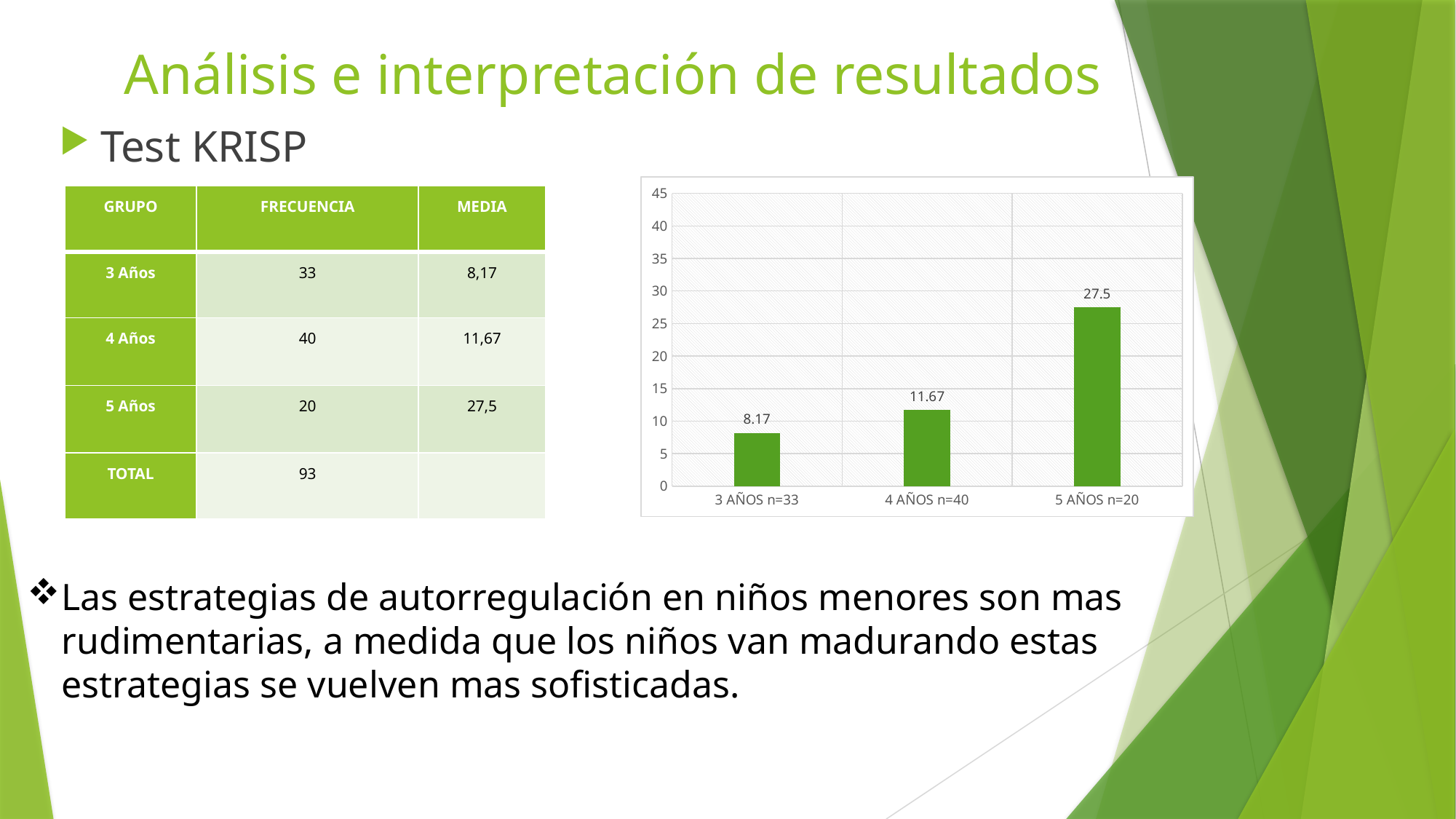
Do the values in the bar chart rise or fall from 3 AÑOS to 5 AÑOS? rise Which category has the lowest value in the bar chart? 3 AÑOS n=33 What kind of chart is shown on the slide? bar chart What is the difference between the values for 5 AÑOS n=20 and 4 AÑOS n=40 in the bar chart? 15.83 Which is larger in the bar chart, the value for 3 AÑOS n=33 or 4 AÑOS n=40? 4 AÑOS n=40 What is the value for 4 AÑOS n=40 in the bar chart? 11.67 What is the value for 5 AÑOS n=20 in the bar chart? 27.5 Is the value for 5 AÑOS n=20 in the bar chart greater or less than 25? greater Which category has the highest value in the bar chart? 5 AÑOS n=20 What is the value for 3 AÑOS n=33 in the bar chart? 8.17 What is the difference between the values for 4 AÑOS n=40 and 3 AÑOS n=33 in the bar chart? 3.5 How many categories are shown in the bar chart? 3